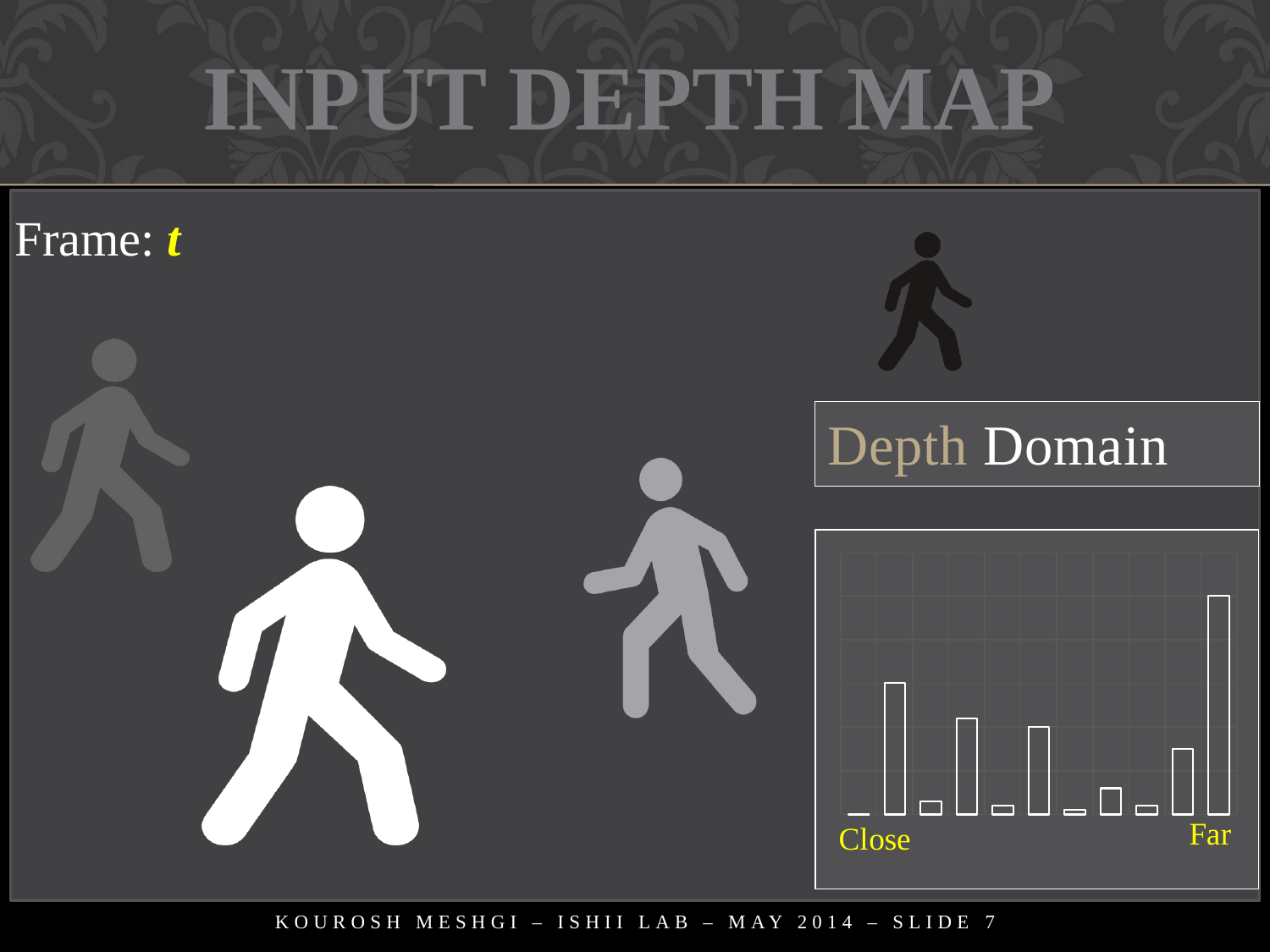
In the Depth Domain chart, which is taller: the second bar from the left or the second bar from the right? the second bar from the left What labels appear at the two ends of the horizontal axis of the Depth Domain chart? Close and Far What is the title shown above the bar chart on the slide? Depth Domain In the Depth Domain chart, which is taller: the rightmost bar or the second bar from the left? the rightmost bar Which bar in the Depth Domain chart is the tallest? the rightmost bar, at the Far end In the Depth Domain chart, is the tallest bar at the Close end or the Far end of the axis? Far In the Depth Domain chart, which is taller: the second bar from the left or the third bar from the left? the second bar from the left What kind of chart is shown in the Depth Domain panel? bar chart How many bars are plotted in the Depth Domain chart? 11